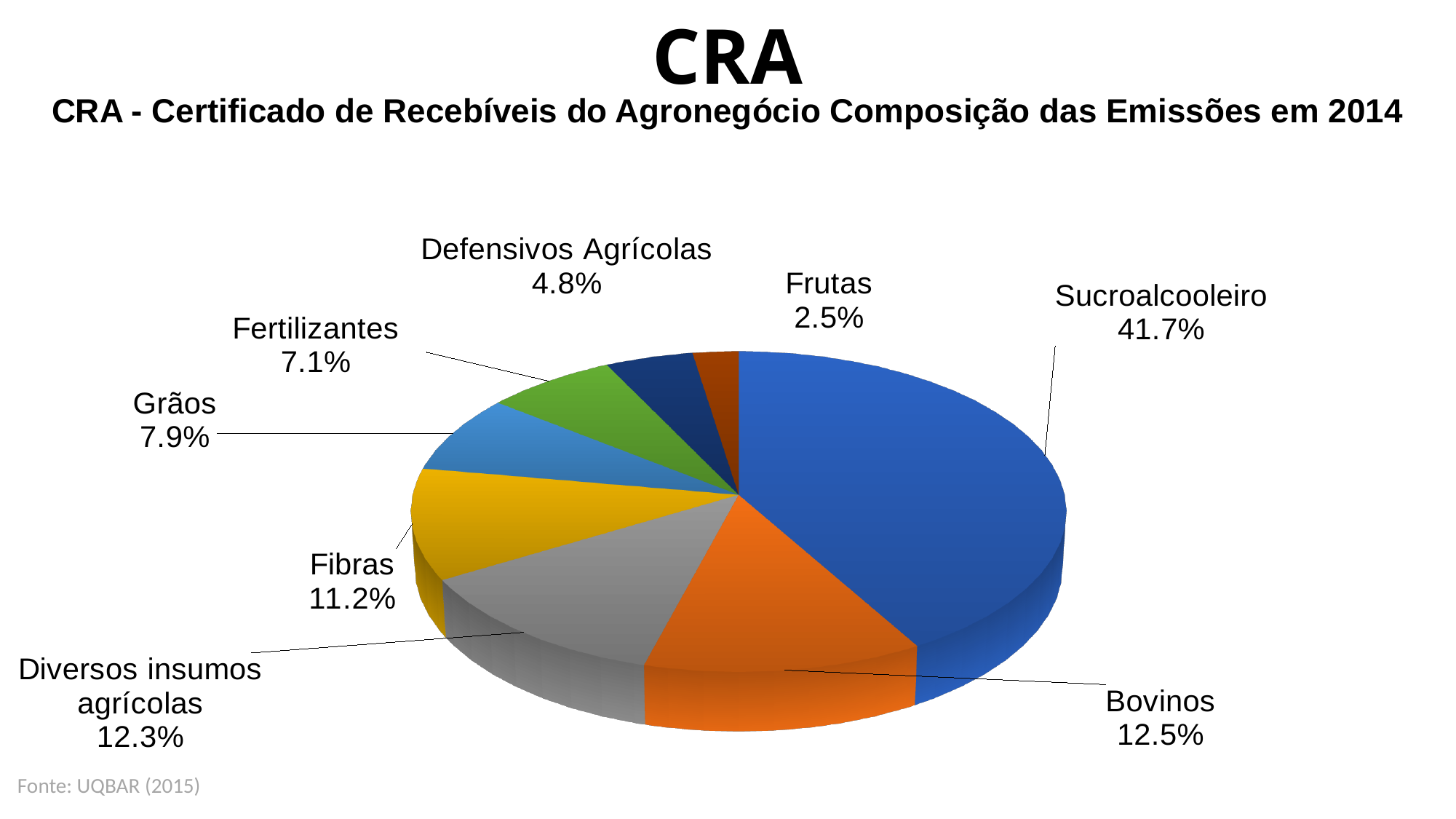
Which category has the smallest slice of the pie? Frutas What is the value shown for Bovinos? 12.5% What is the difference between the shares of Fibras and Grãos? 3.3% How many categories are shown in the pie chart? 8 What kind of chart is shown on the slide? Pie chart Which is larger, the share for Grãos or the share for Fertilizantes? Grãos What is the value shown for Diversos insumos agrícolas? 12.3% What colour is the Sucroalcooleiro slice? Blue What is the difference between the shares of Sucroalcooleiro and Bovinos? 29.2% What is the value shown for Fertilizantes? 7.1% What share of the pie does Sucroalcooleiro hold? 41.7% Which category has the largest slice of the pie? Sucroalcooleiro